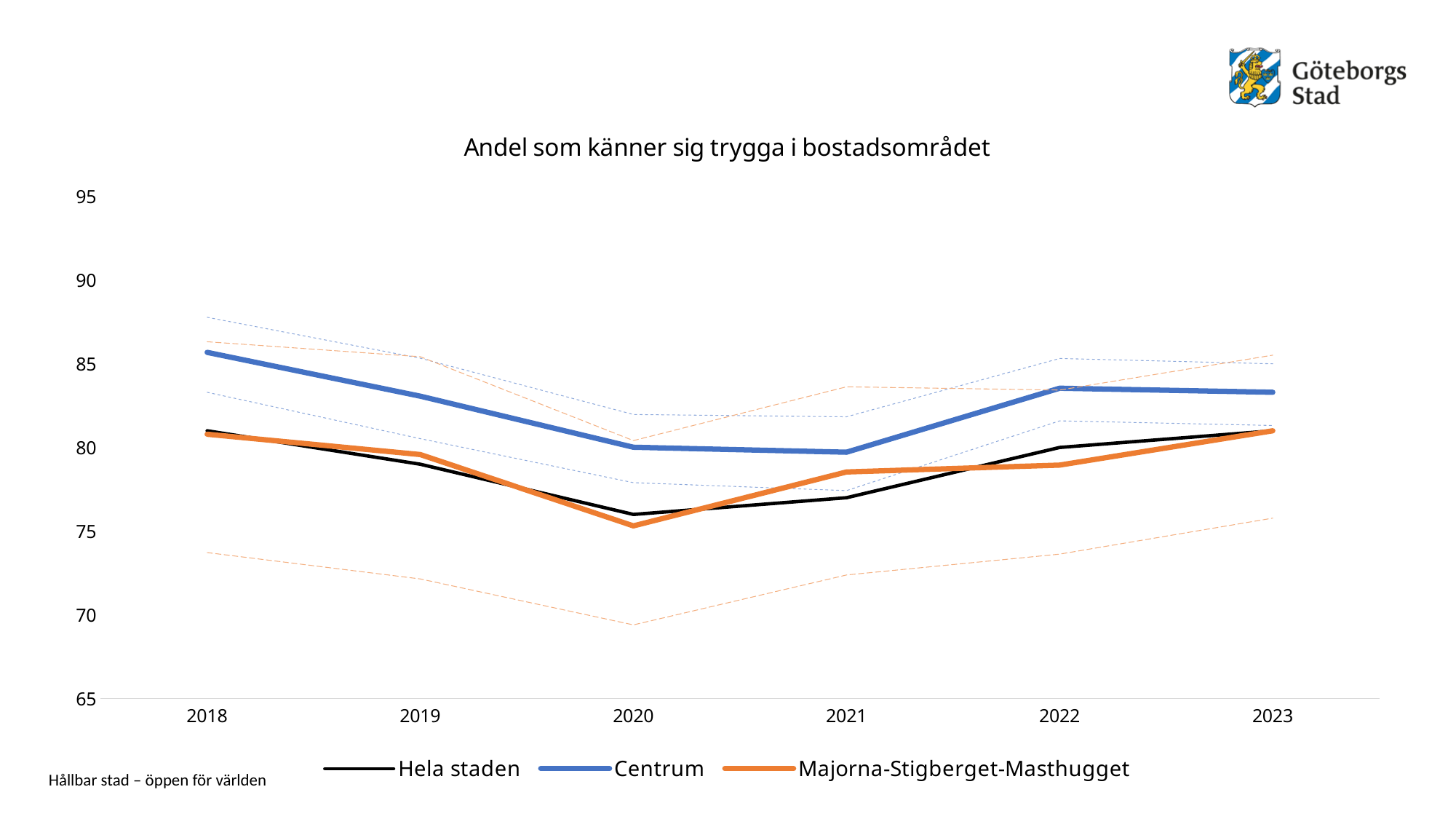
Is the value for Majorna-Stigberget-Masthugget in 2021 greater or less than 80? less Is the value for Hela staden in 2020 greater or less than 75? greater How many series does the legend list? 3 What kind of chart is shown on the slide? Line chart In 2018, which is higher: Centrum or Hela staden? Centrum In which year is the value for Hela staden lowest? 2020 Which series is drawn in orange? Majorna-Stigberget-Masthugget Is the value for Centrum in 2018 greater or less than 85? greater In 2021, which is higher: Majorna-Stigberget-Masthugget or Hela staden? Majorna-Stigberget-Masthugget How many years are shown on the x axis? 6 What is the title of the chart? Andel som känner sig trygga i bostadsområdet